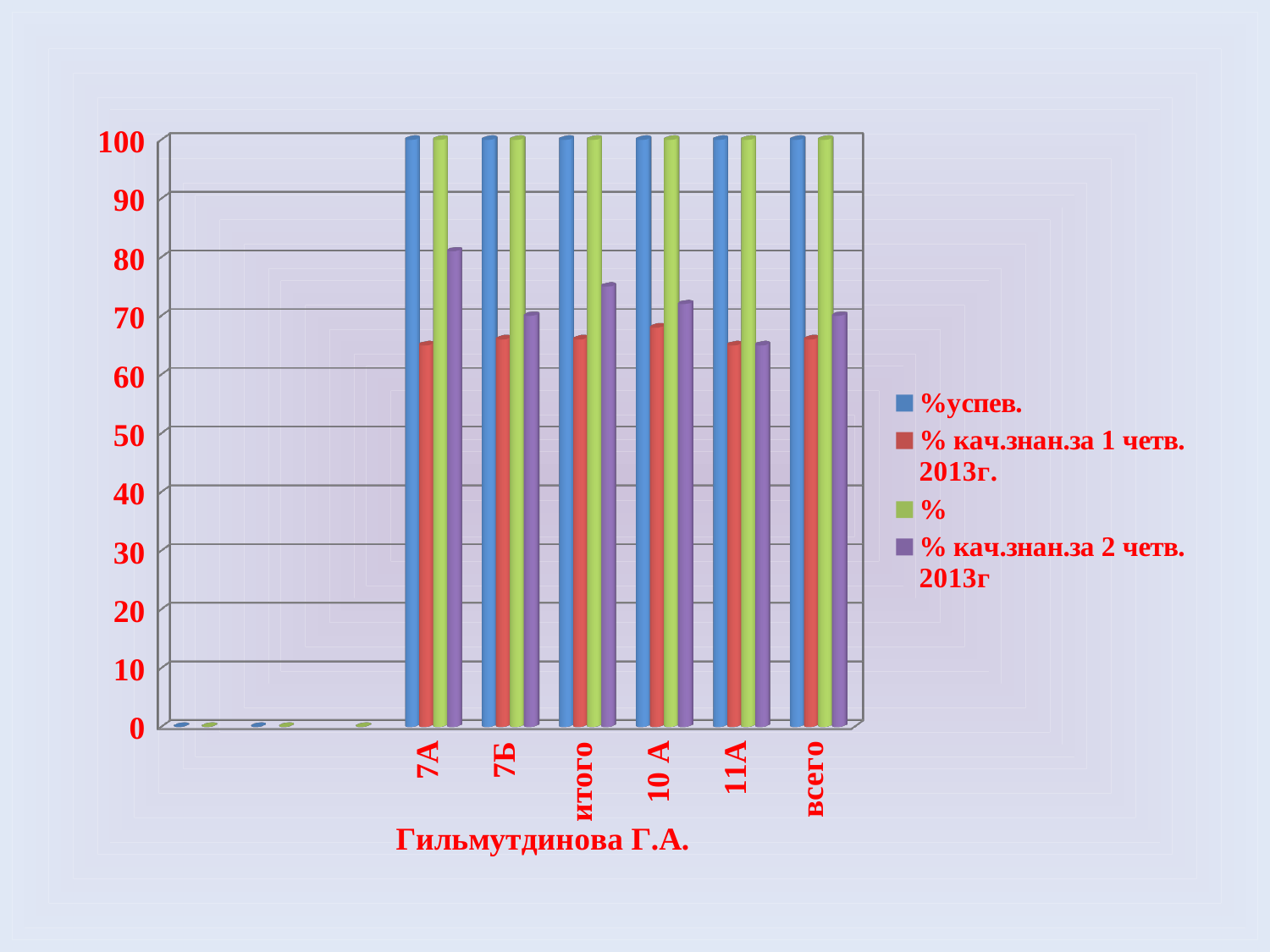
What is the value of the %успев. series for 7А? 100 What is the value of the % series for всего? 100 What name is written below the x axis of the chart? Гильмутдинова Г.А. How many labelled categories are shown on the x axis? 6 Which is larger for итого: % кач.знан.за 2 четв. 2013г or % кач.знан.за 1 четв. 2013г.? % кач.знан.за 2 четв. 2013г Is the value of % кач.знан.за 2 четв. 2013г for 7А greater or less than 70? greater How many series does the legend list? 4 Is the value of % кач.знан.за 1 четв. 2013г. for 7Б greater or less than 70? less Is the value of % кач.знан.за 2 четв. 2013г for 11А greater or less than 70? less Which category has the highest value for % кач.знан.за 2 четв. 2013г? 7А What kind of chart is shown on the slide? bar chart Which is larger for 7А: % кач.знан.за 1 четв. 2013г. or % кач.знан.за 2 четв. 2013г? % кач.знан.за 2 четв. 2013г